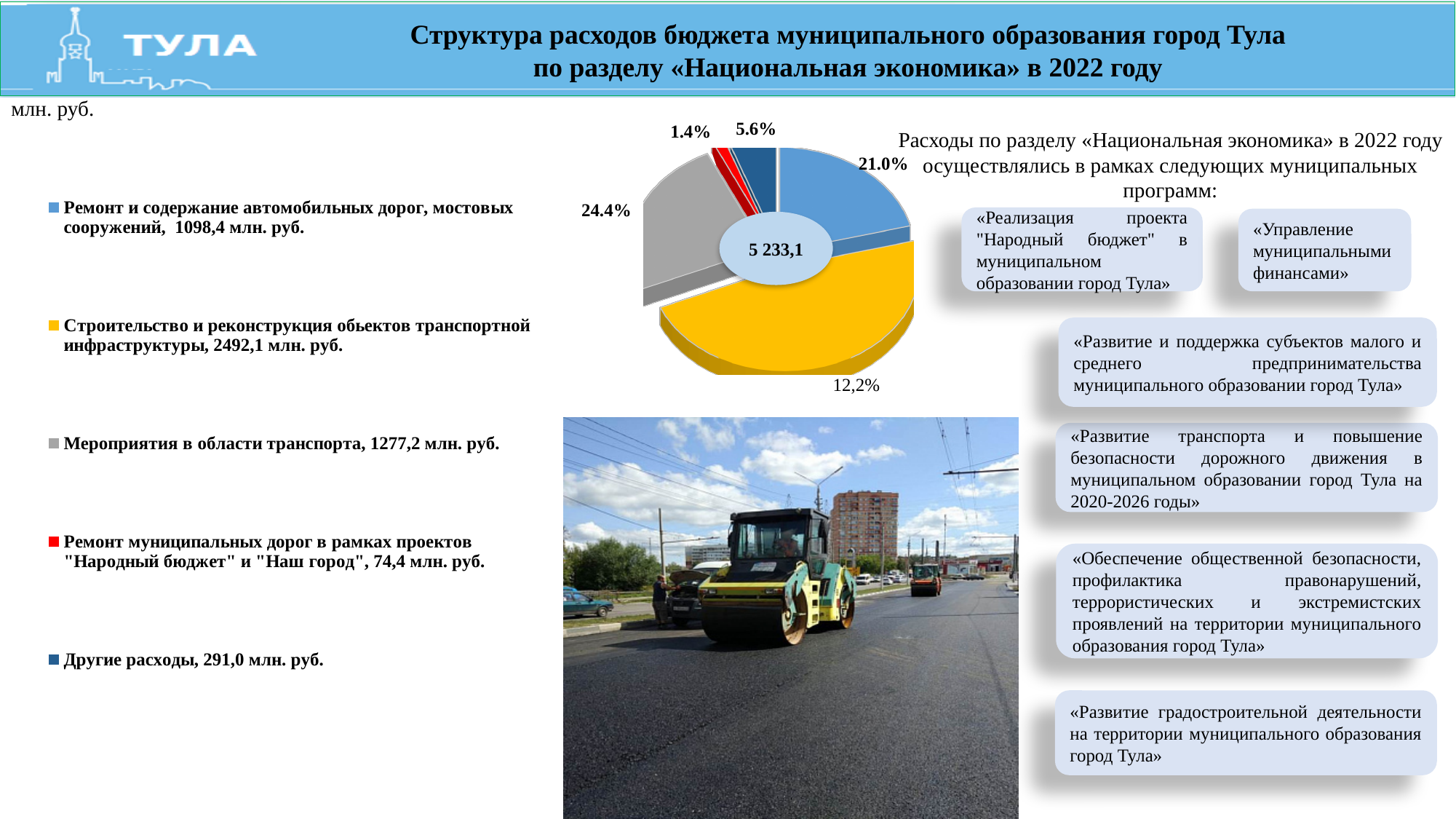
What is the value for «Мероприятия в области транспорта»? 1277,2 млн. руб. How many categories does the legend of the pie chart list? 5 What is the value for «Другие расходы»? 291,0 млн. руб. Which category has the largest value in the pie chart? Строительство и реконструкция объектов транспортной инфраструктуры What is the value for «Строительство и реконструкция объектов транспортной инфраструктуры»? 2492,1 млн. руб. What kind of chart is shown on the slide? pie chart What is the value for «Ремонт и содержание автомобильных дорог, мостовых сооружений»? 1098,4 млн. руб. Which category has the smallest value in the pie chart? Ремонт муниципальных дорог в рамках проектов "Народный бюджет" и "Наш город" What total value is shown in the centre of the pie chart? 5 233,1 What share of the pie does «Другие расходы» (dark blue slice) represent? 5.6% What is the value for «Ремонт муниципальных дорог в рамках проектов "Народный бюджет" и "Наш город"»? 74,4 млн. руб. What is the difference between «Мероприятия в области транспорта» and «Ремонт и содержание автомобильных дорог, мостовых сооружений»? 178,8 млн. руб.